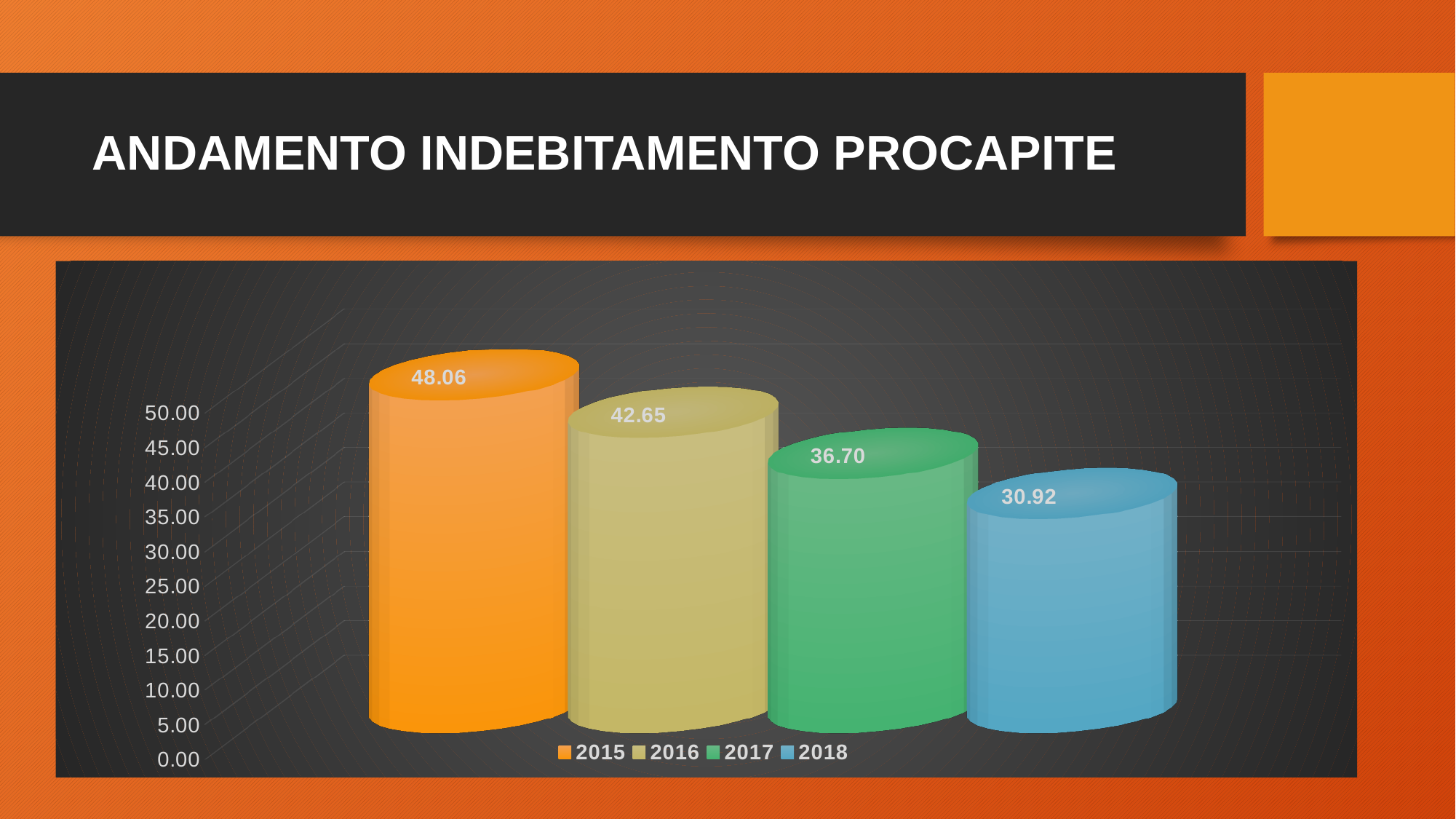
Which is larger, the value for 2016 or the value for 2017? 2016 What is the title of the slide containing the chart? ANDAMENTO INDEBITAMENTO PROCAPITE Which year has the highest value? 2015 How many bars are shown in the chart? 4 What is the value for 2015? 48.06 Which year has the lowest value? 2018 What is the value for 2017? 36.70 What is the difference between the values for 2016 and 2017? 5.95 What is the difference between the values for 2015 and 2018? 17.14 Do the values rise or fall from 2015 to 2018? fall What is the value for 2016? 42.65 What is the value for 2018? 30.92